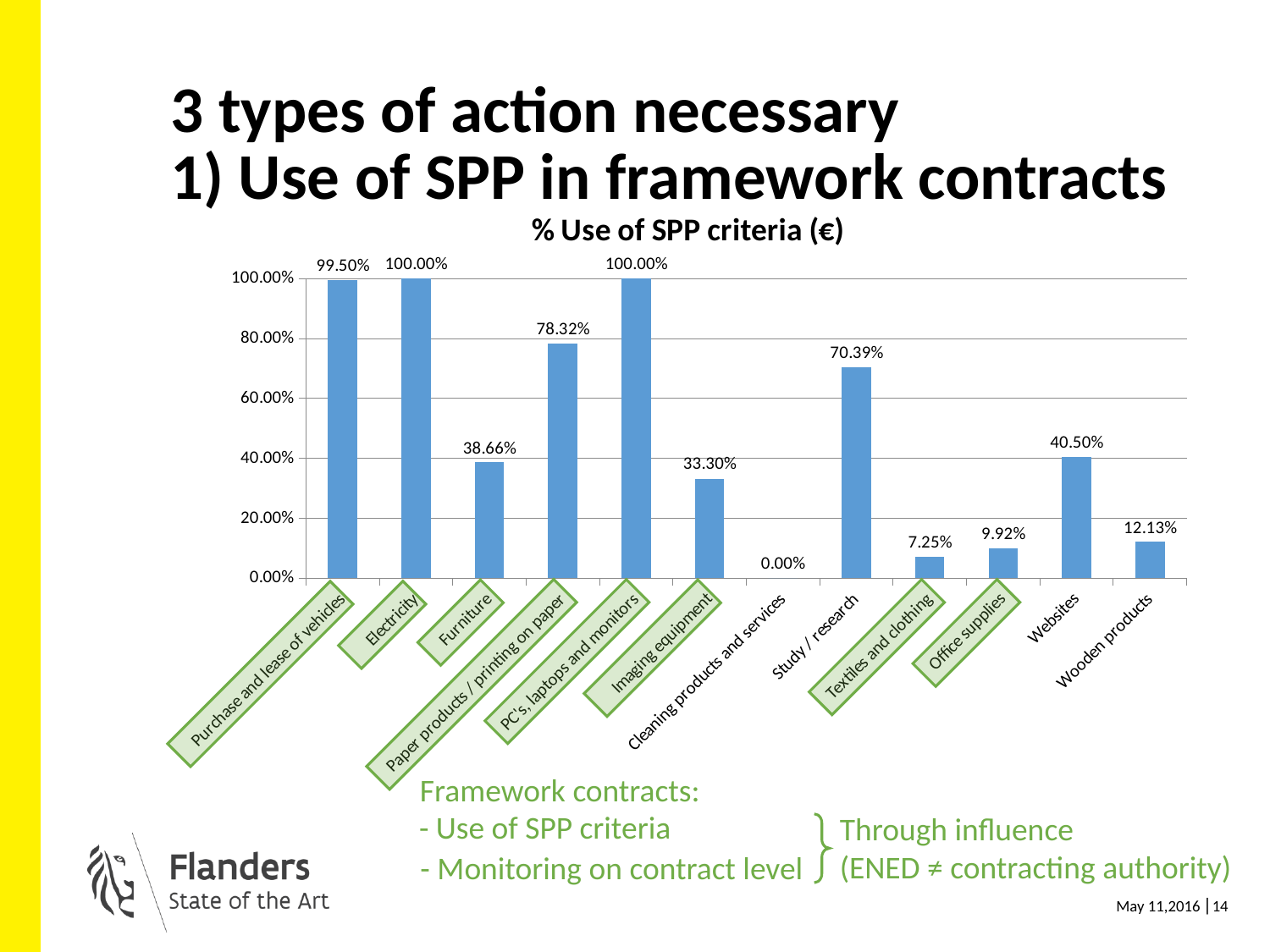
What is the value for Furniture? 38.66% What is the difference between the values for Paper products / printing on paper and Imaging equipment? 45.02% What is the title of the chart? % Use of SPP criteria (€) What is the value for Textiles and clothing? 7.25% What kind of chart is shown? bar chart Which category has the lowest value? Cleaning products and services What is the value for Study / research? 70.39% What is the difference between the values for Wooden products and Office supplies? 2.21% What is the value for Websites? 40.50% Is the value for Purchase and lease of vehicles greater or less than 80.00%? greater Which is larger, the value for Websites or the value for Furniture? Websites How many categories are shown on the x axis? 12